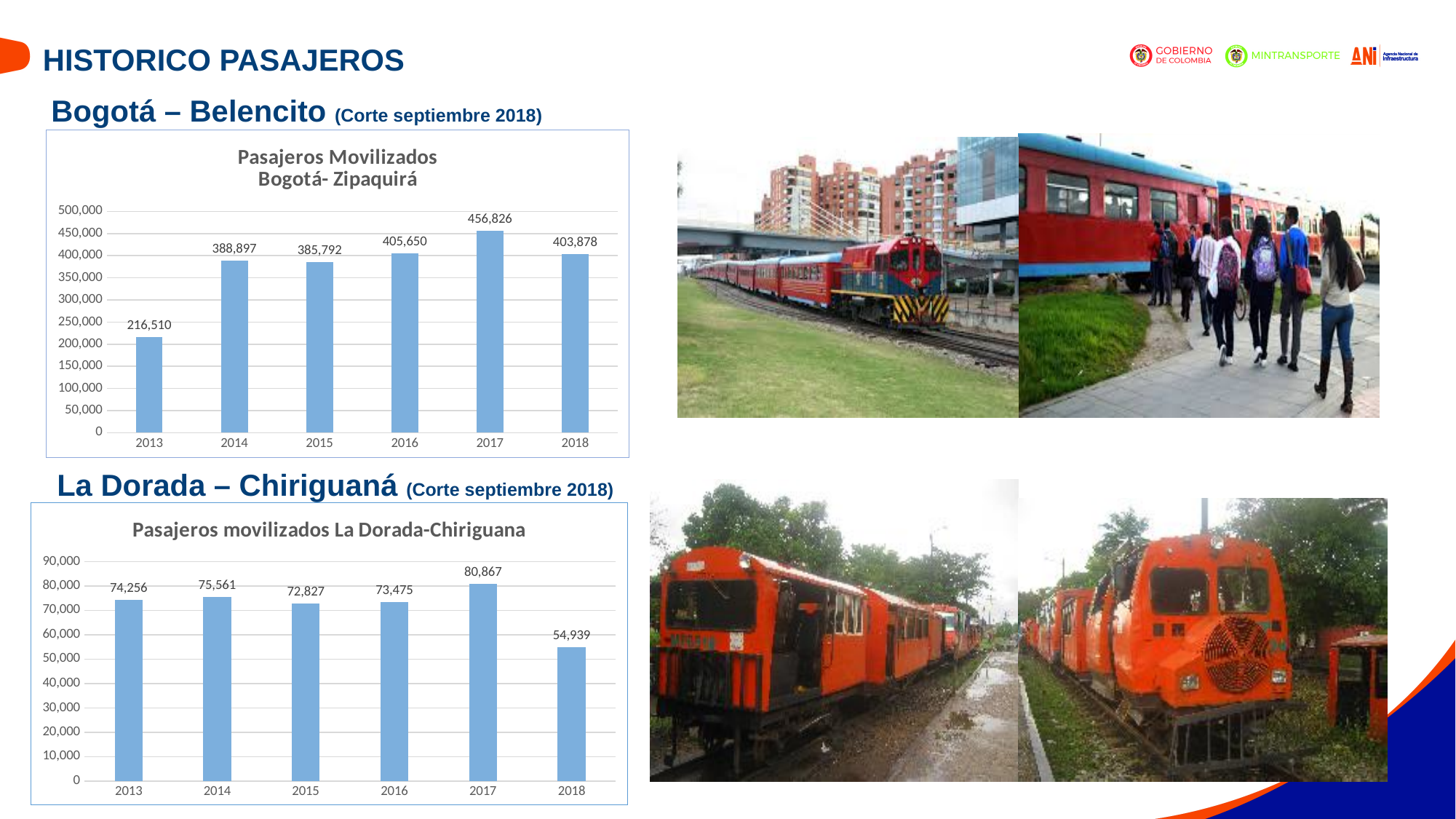
In the chart 'Pasajeros movilizados La Dorada-Chiriguana', what is the difference between the 2017 and 2018 values? 25,928 In the chart 'Pasajeros Movilizados Bogotá- Zipaquirá', which year has the highest value? 2017 In the chart 'Pasajeros Movilizados Bogotá- Zipaquirá', what is the difference between the 2017 and 2013 values? 240,316 What kind of chart is 'Pasajeros movilizados La Dorada-Chiriguana'? bar chart In the chart 'Pasajeros Movilizados Bogotá- Zipaquirá', what is the value for 2013? 216,510 In the chart 'Pasajeros movilizados La Dorada-Chiriguana', what is the value for 2018? 54,939 In the chart 'Pasajeros movilizados La Dorada-Chiriguana', is the value for 2014 larger or smaller than the value for 2016? larger In the chart 'Pasajeros Movilizados Bogotá- Zipaquirá', what is the value for 2017? 456,826 In the chart 'Pasajeros movilizados La Dorada-Chiriguana', what is the value for 2015? 72,827 In the chart 'Pasajeros Movilizados Bogotá- Zipaquirá', how many years are shown on the x axis? 6 In the chart 'Pasajeros movilizados La Dorada-Chiriguana', which year has the highest value? 2017 In the chart 'Pasajeros Movilizados Bogotá- Zipaquirá', which year has the lowest value? 2013